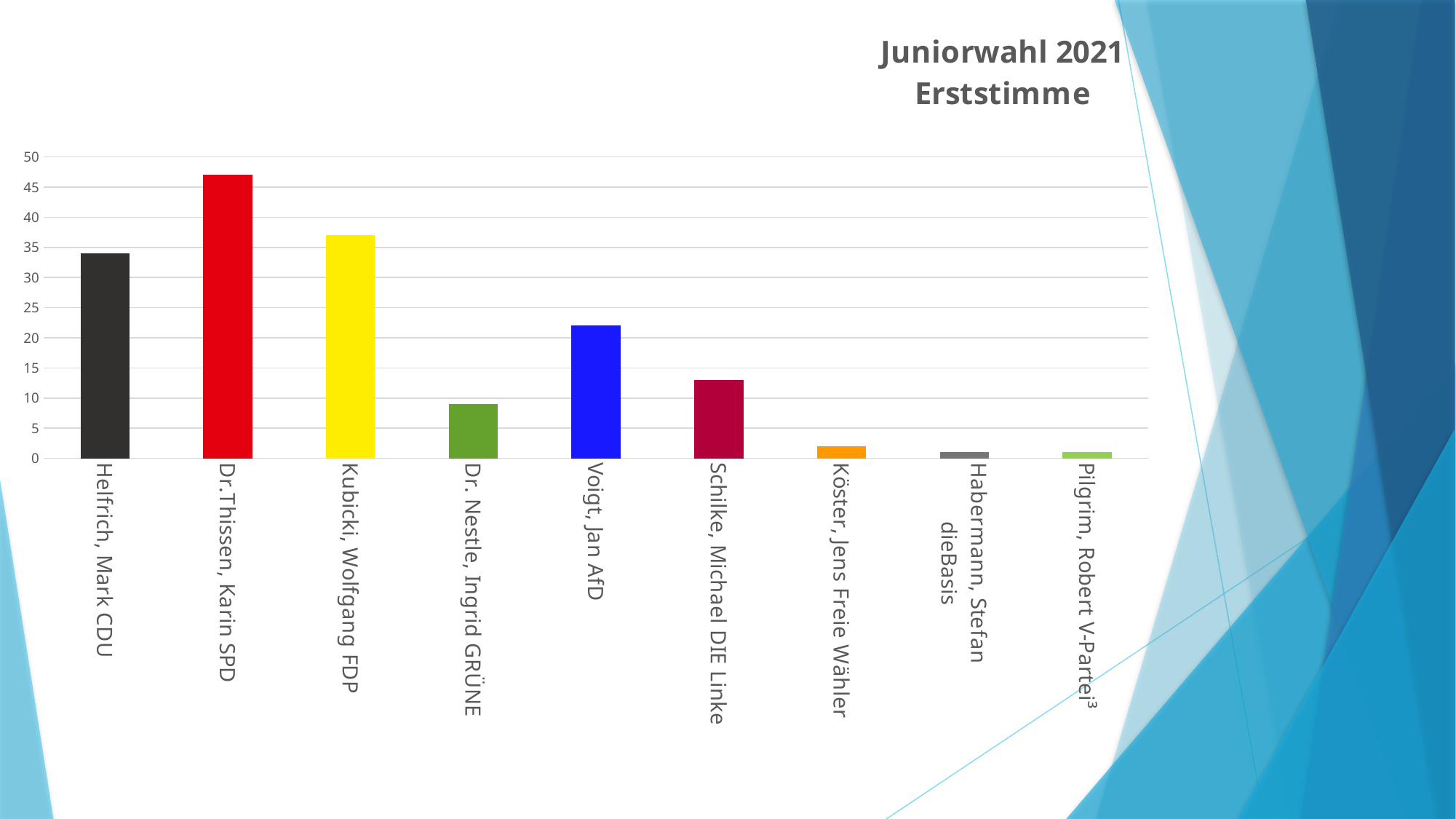
How many candidates are shown on the x axis of the chart? 9 Is the value for Voigt, Jan AfD greater or less than 20? greater Which candidate has the highest bar in the chart? Dr.Thissen, Karin SPD Is the value for Dr.Thissen, Karin SPD greater or less than 45? greater Is the value for Kubicki, Wolfgang FDP greater or less than 40? less What is the title of the chart? Juniorwahl 2021 Erststimme What kind of chart is shown on the slide? bar chart Which has the larger value, Kubicki, Wolfgang FDP or Helfrich, Mark CDU? Kubicki, Wolfgang FDP What colour is the bar for Voigt, Jan AfD? blue